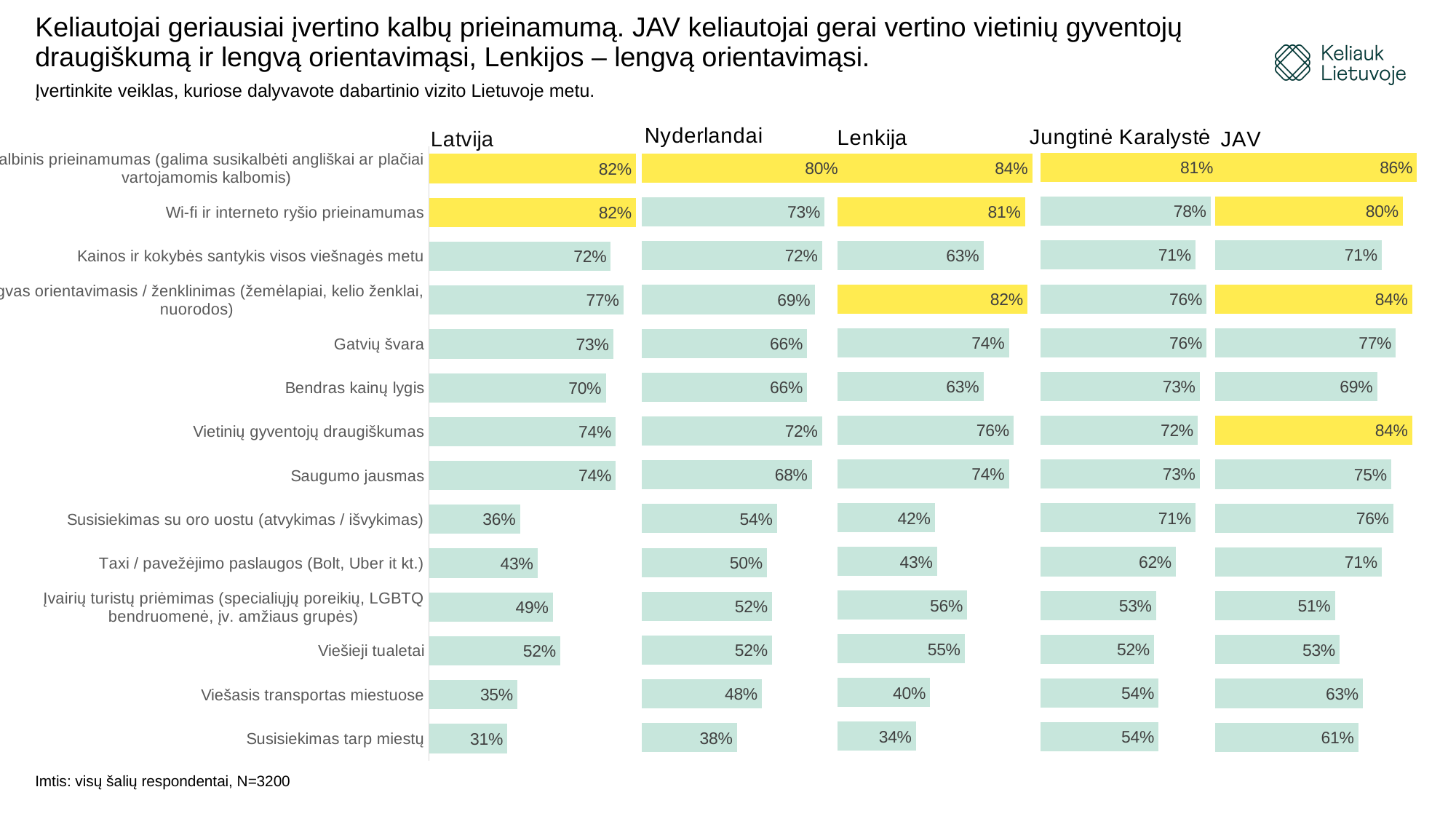
In the JAV chart, what is the value for Vietinių gyventojų draugiškumas? 84% How many categories are plotted in each country chart? 14 What type of chart is used on this slide? Bar chart In the Latvija chart, what is the value for Wi-fi ir interneto ryšio prieinamumas? 82% Across the five country charts, which country has the highest value for Taxi / pavežėjimo paslaugos (Bolt, Uber it kt.)? JAV In the Lenkija chart, what is the value for Viešieji tualetai? 55% How many country charts are shown on the slide? 5 In the Nyderlandai chart, which category has the lowest value? Susisiekimas tarp miestų In the Jungtinė Karalystė chart, what is the value for Susisiekimas su oro uostu (atvykimas / išvykimas)? 71% In the Lenkija chart, which is larger: Saugumo jausmas or Bendras kainų lygis? Saugumo jausmas In the Latvija chart, which category has the lowest value? Susisiekimas tarp miestų In the JAV chart, what is the difference between Gatvių švara and Viešasis transportas miestuose? 14%